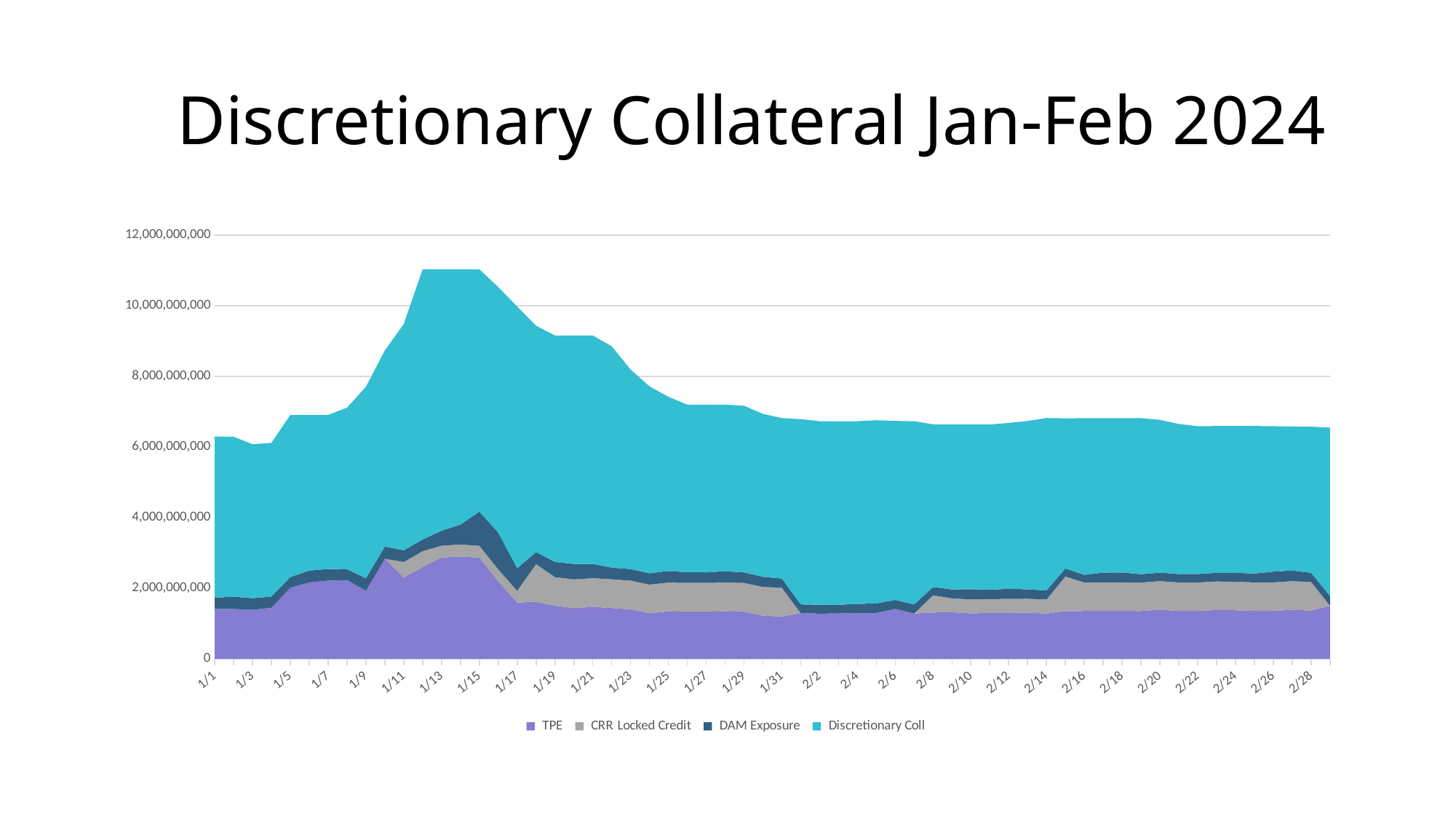
Is the stacked total on 1/13 greater or less than 10,000,000,000? greater How many series does the legend list? 4 What kind of chart is shown on the slide? Stacked area chart Which series contributes the largest share of the stacked total across the period? Discretionary Coll Is the TPE value on 1/1 greater or less than 2,000,000,000? less Is the stacked total on 1/1 greater or less than 8,000,000,000? less What is the title of the chart? Discretionary Collateral Jan-Feb 2024 Which series is plotted at the bottom of the stack? TPE Does the stacked total rise or fall between 1/15 and 1/23? Fall